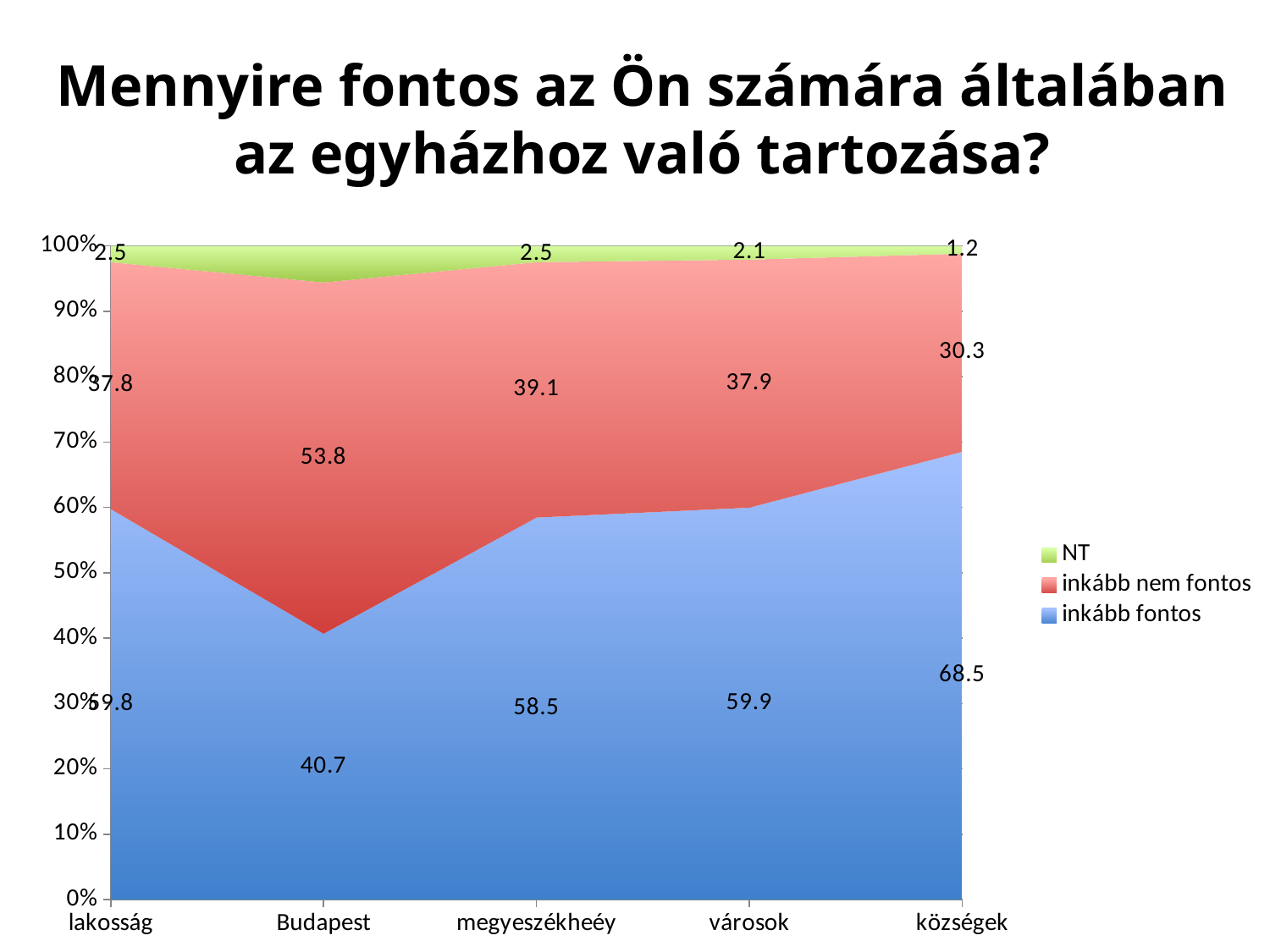
How many series does the legend list? 3 What kind of chart is shown on the slide? Stacked area chart What is the value for "inkább fontos" for lakosság? 59.8 Which category has the highest value for "inkább fontos"? községek Which is larger: the "inkább nem fontos" value for Budapest or for megyeszékheéy? Budapest What is the value for "inkább fontos" in Budapest? 40.7 What is the difference between the "inkább fontos" values for községek and Budapest? 27.8 Which category has the highest value for "inkább nem fontos"? Budapest How many categories are shown on the x axis? 5 What is the value for "inkább nem fontos" in községek? 30.3 Which category has the lowest value for "inkább fontos"? Budapest What is the NT value for városok? 2.1